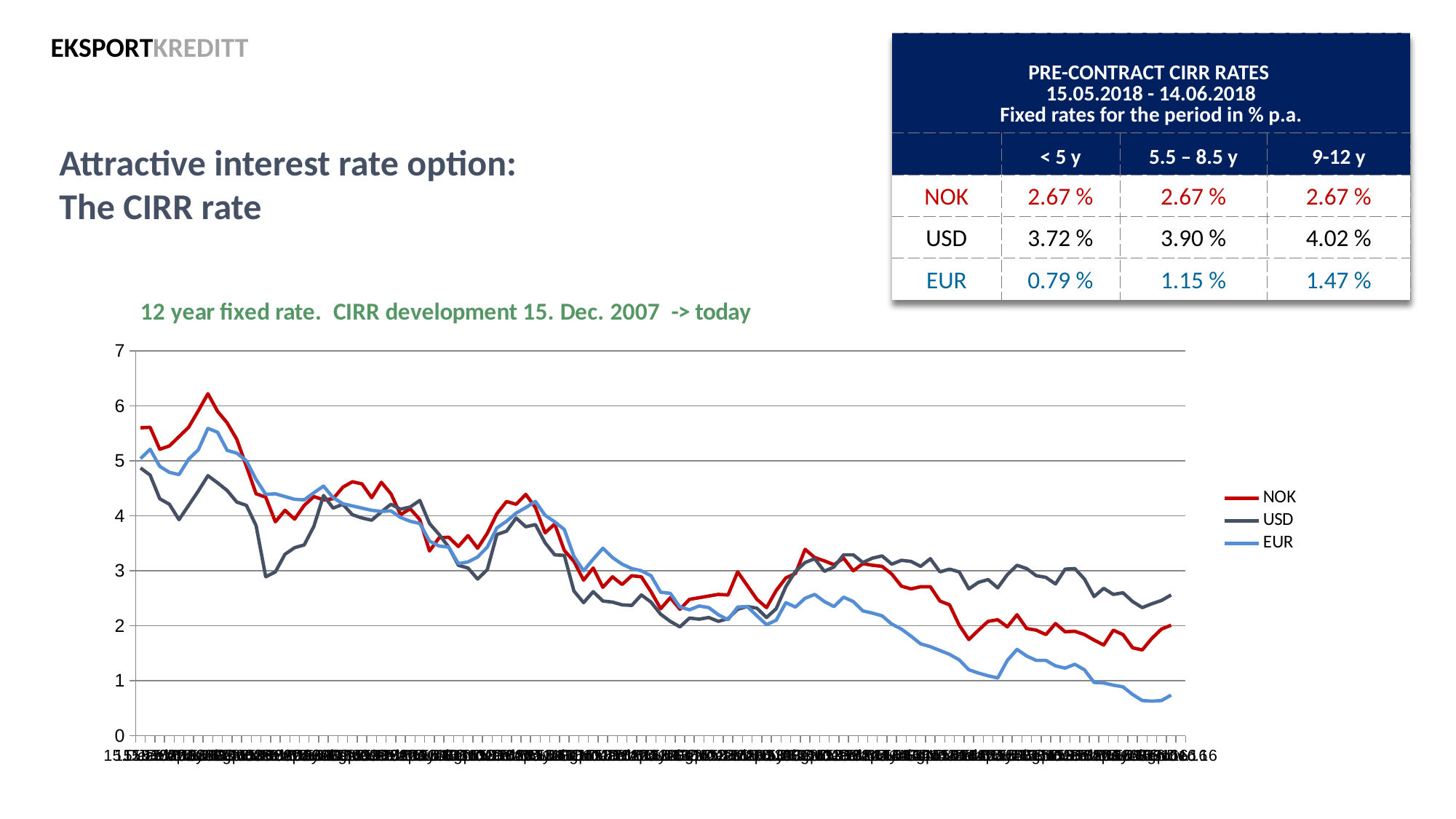
Do the values of the EUR series generally rise or fall from left to right along the x axis? fall Do the values of the NOK series generally rise or fall from left to right along the x axis? fall How many series does the legend of the line chart list? 3 At the right end of the chart, is the value of the EUR series greater or less than 1? less Which series are listed in the legend of the line chart? NOK, USD, EUR What is the title of the line chart? 12 year fixed rate. CIRR development 15. Dec. 2007 -> today At the left end of the chart, is the value of the NOK series greater or less than 5? greater At the right end of the chart, which is larger, the NOK value or the EUR value? NOK At the right end of the chart, which series has the highest value? USD At the right end of the chart, is the value of the USD series greater or less than 2? greater At the right end of the chart, which series has the lowest value? EUR What kind of chart is shown on the slide? line chart